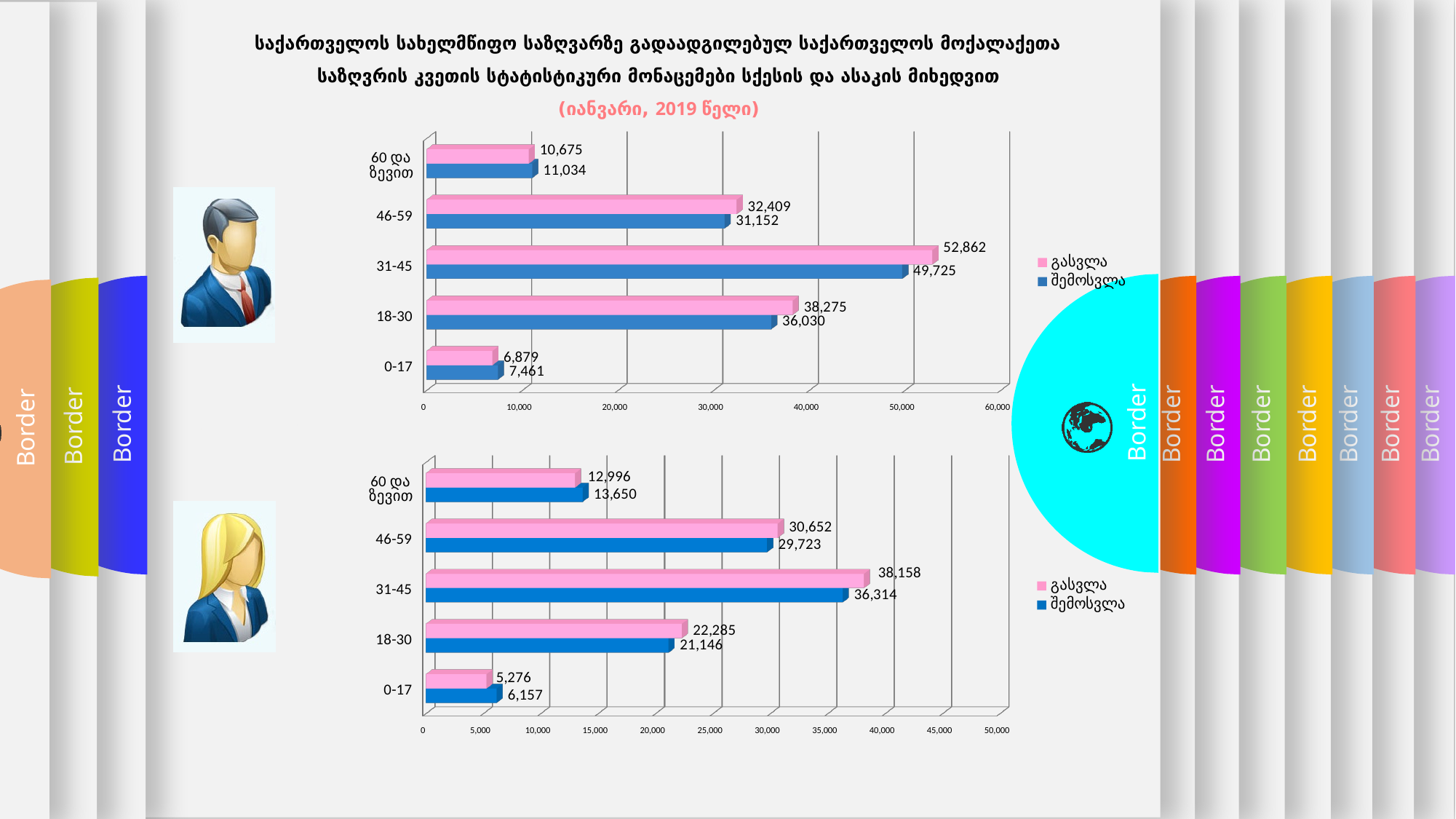
In the bottom chart, what is the value of შემოსვლა for the 60 და ზევით age group? 13,650 In the top chart, which is larger for the 60 და ზევით age group: გასვლა or შემოსვლა? შემოსვლა What type of chart is the bottom chart? Bar chart In the bottom chart, which age group has the lowest შემოსვლა value? 0-17 In the top chart, what is the value of გასვლა for the 31-45 age group? 52,862 In the bottom chart, what is the value of გასვლა for the 18-30 age group? 22,285 In the top chart, what is the value of შემოსვლა for the 0-17 age group? 7,461 How many age groups are shown in the bottom chart? 5 In the top chart, which age group has the highest გასვლა value? 31-45 In the top chart, what is the difference between გასვლა and შემოსვლა for the 31-45 age group? 3,137 In the bottom chart, what is the difference between შემოსვლა and გასვლა for the 0-17 age group? 881 How many series does the legend of the top chart list? 2